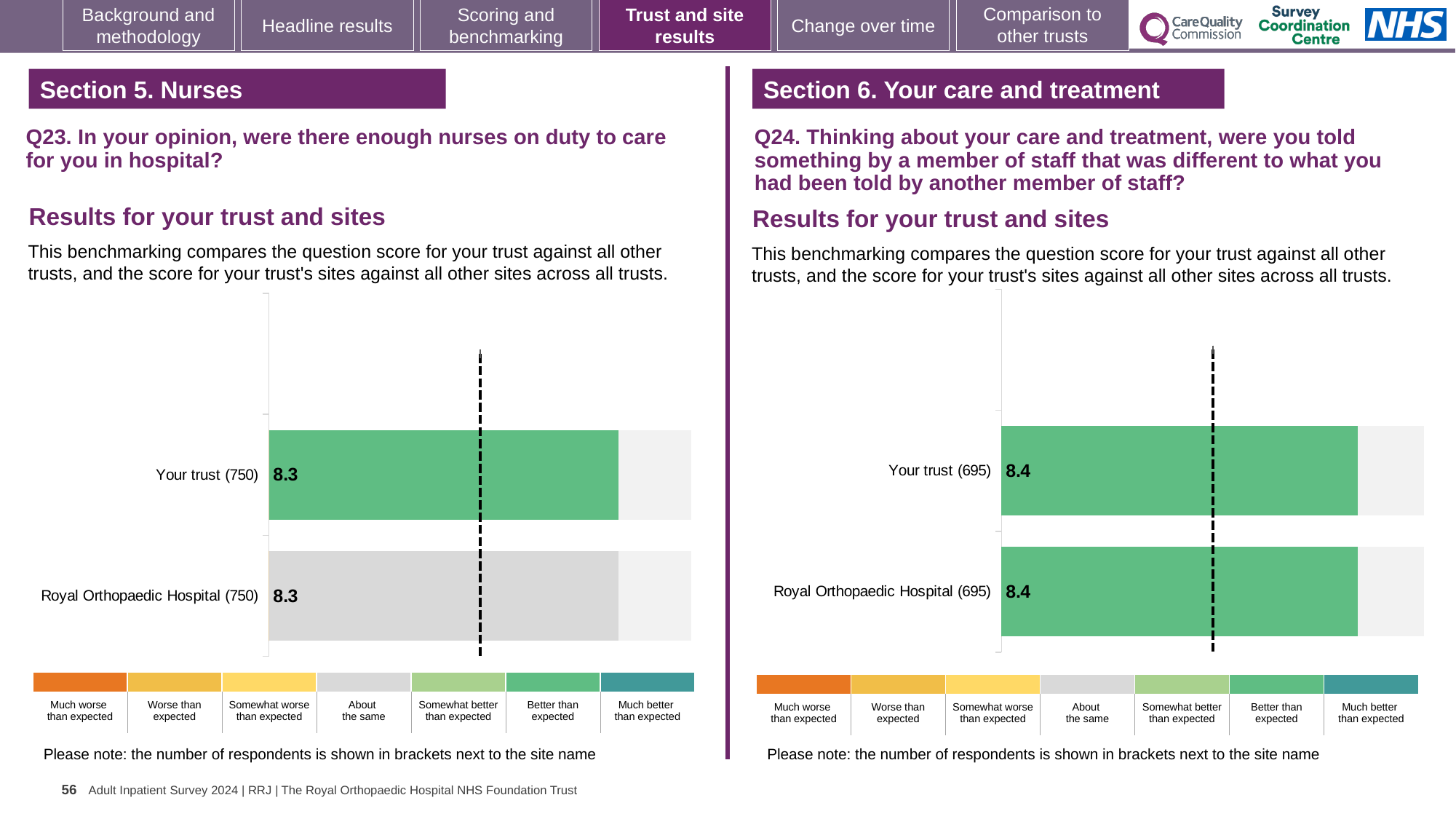
In the Q23 chart on the left, what colour is the bar for Royal Orthopaedic Hospital (750)? Grey In the Q24 chart on the right, what is the score for Your trust (695)? 8.4 How many respondents are shown in brackets for Your trust in the Q24 chart on the right? 695 How many bars are plotted in the Q23 chart on the left? 2 In the Q24 chart on the right, what is the difference between the score for Your trust (695) and the score for Royal Orthopaedic Hospital (695)? 0 In the Q23 chart on the left, what is the score for Royal Orthopaedic Hospital (750)? 8.3 How many bars are plotted in the Q24 chart on the right? 2 In the Q23 chart on the left, what is the score for Your trust (750)? 8.3 In the Q24 chart on the right, what is the score for Royal Orthopaedic Hospital (695)? 8.4 Is the score for Your trust (695) in the Q24 chart on the right greater or less than the score for Your trust (750) in the Q23 chart on the left? greater In the Q23 chart on the left, what is the difference between the score for Your trust (750) and the score for Royal Orthopaedic Hospital (750)? 0 What kind of chart is used for the Q23 results on the left? Bar chart